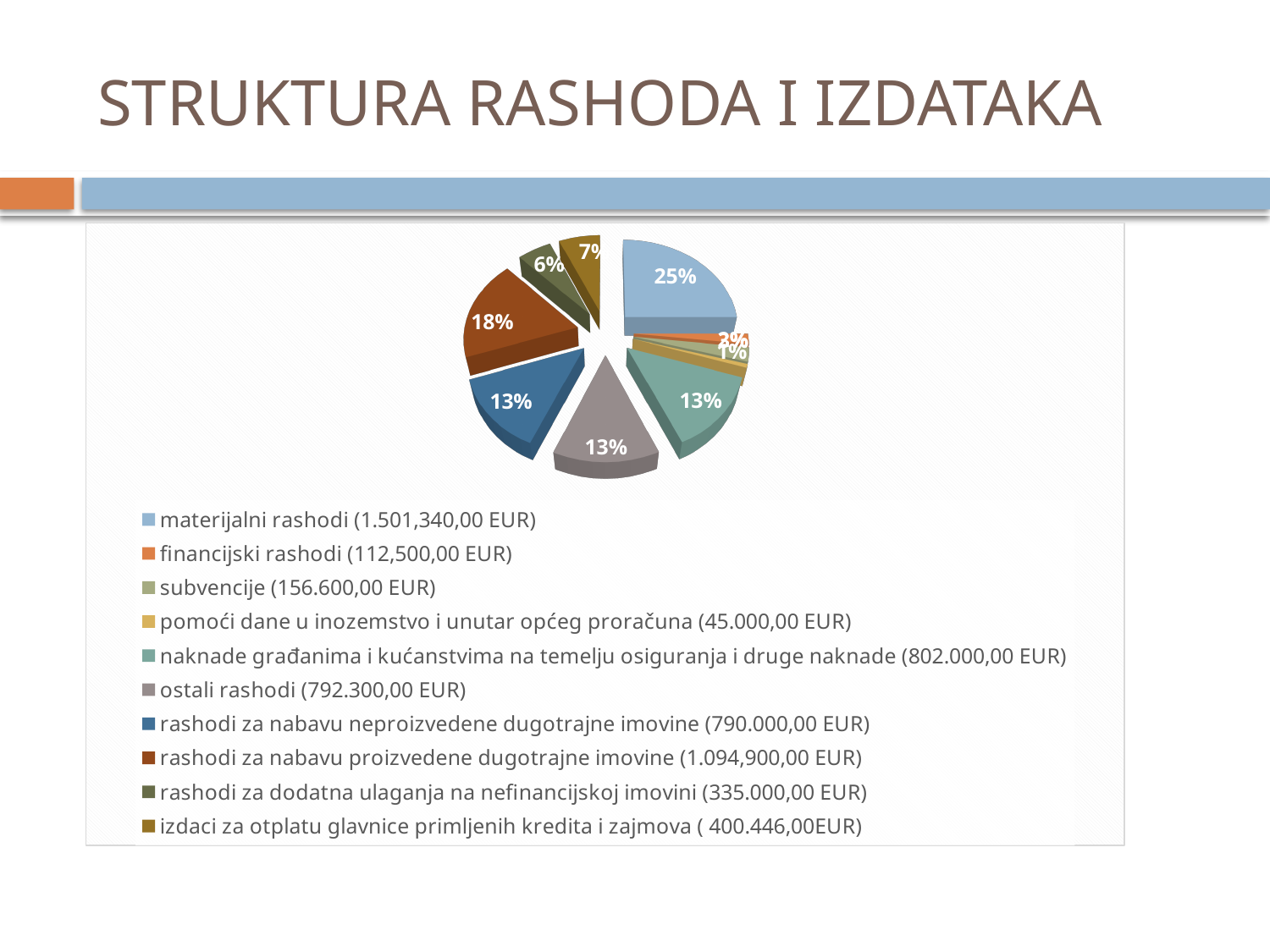
What percentage is shown for 'rashodi za nabavu proizvedene dugotrajne imovine'? 18% How many categories does the pie chart's legend list? 10 By how many percentage points does the 'materijalni rashodi' slice exceed the 'rashodi za nabavu proizvedene dugotrajne imovine' slice? 7 What percentage is shown for 'rashodi za dodatna ulaganja na nefinancijskoj imovini'? 6% According to the legend, which category has the smallest amount in EUR? pomoći dane u inozemstvo i unutar općeg proračuna What amount in EUR does the legend give for 'naknade građanima i kućanstvima na temelju osiguranja i druge naknade'? 802.000,00 EUR What kind of chart is shown on the slide? pie chart What percentage is shown for 'izdaci za otplatu glavnice primljenih kredita i zajmova'? 7% Which slice is larger: 'materijalni rashodi' or 'rashodi za nabavu proizvedene dugotrajne imovine'? materijalni rashodi Which category has the largest slice of the pie? materijalni rashodi What is the title of the slide containing the pie chart? STRUKTURA RASHODA I IZDATAKA